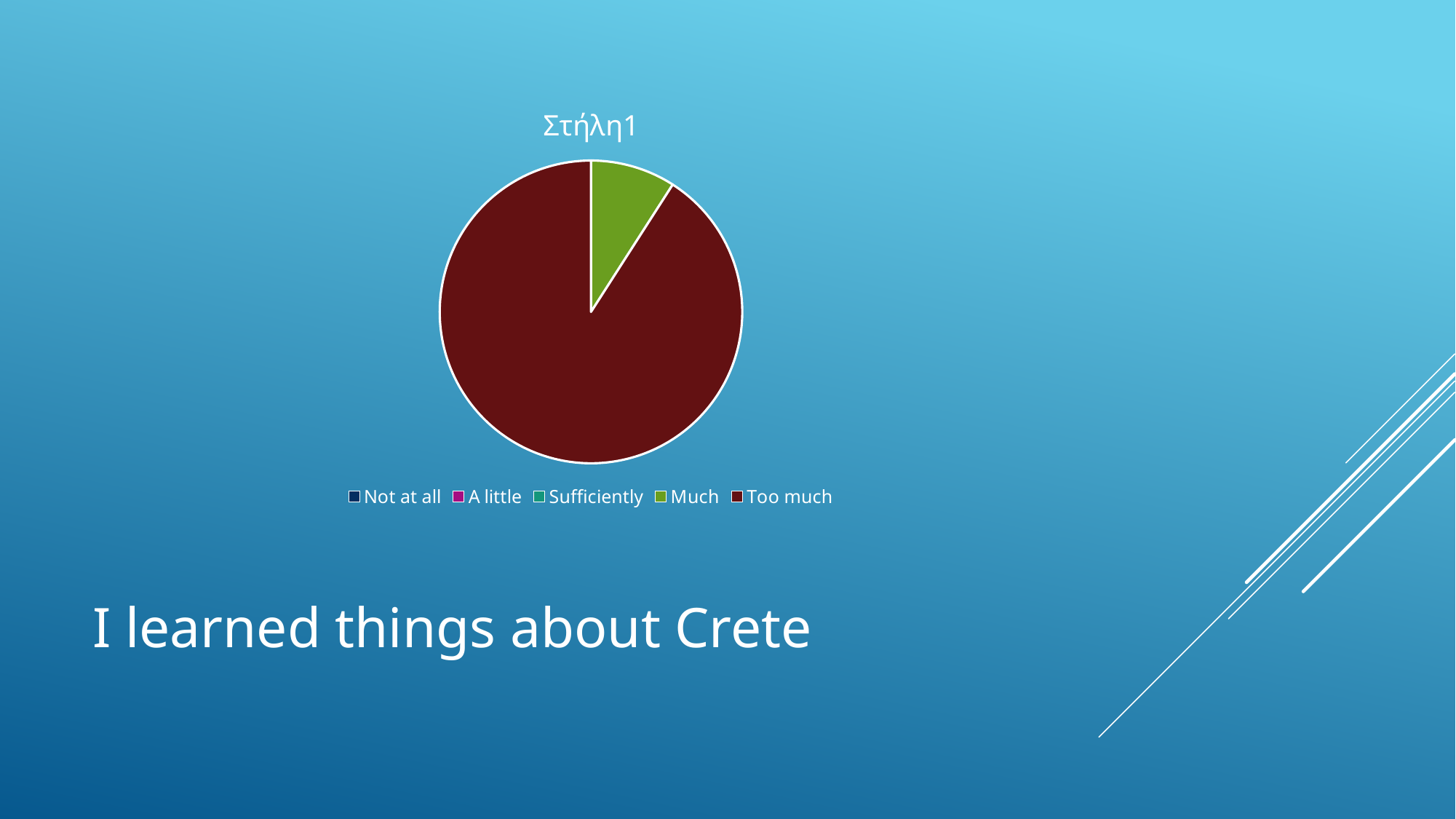
What kind of chart is shown on the slide? Pie chart How many categories does the chart's legend list? 5 Does the Too much slice take up more or less than half of the pie? More Which category is listed first in the legend? Not at all Which category has the largest slice of the pie? Too much Does the Much slice take up more or less than a quarter of the pie? Less How many slices are visibly drawn in the pie? 2 What is the title of the chart? Στήλη1 What colour is the Too much slice? Dark red Which legend entry corresponds to the green slice? Much Which of the two visible slices is larger, Much or Too much? Too much